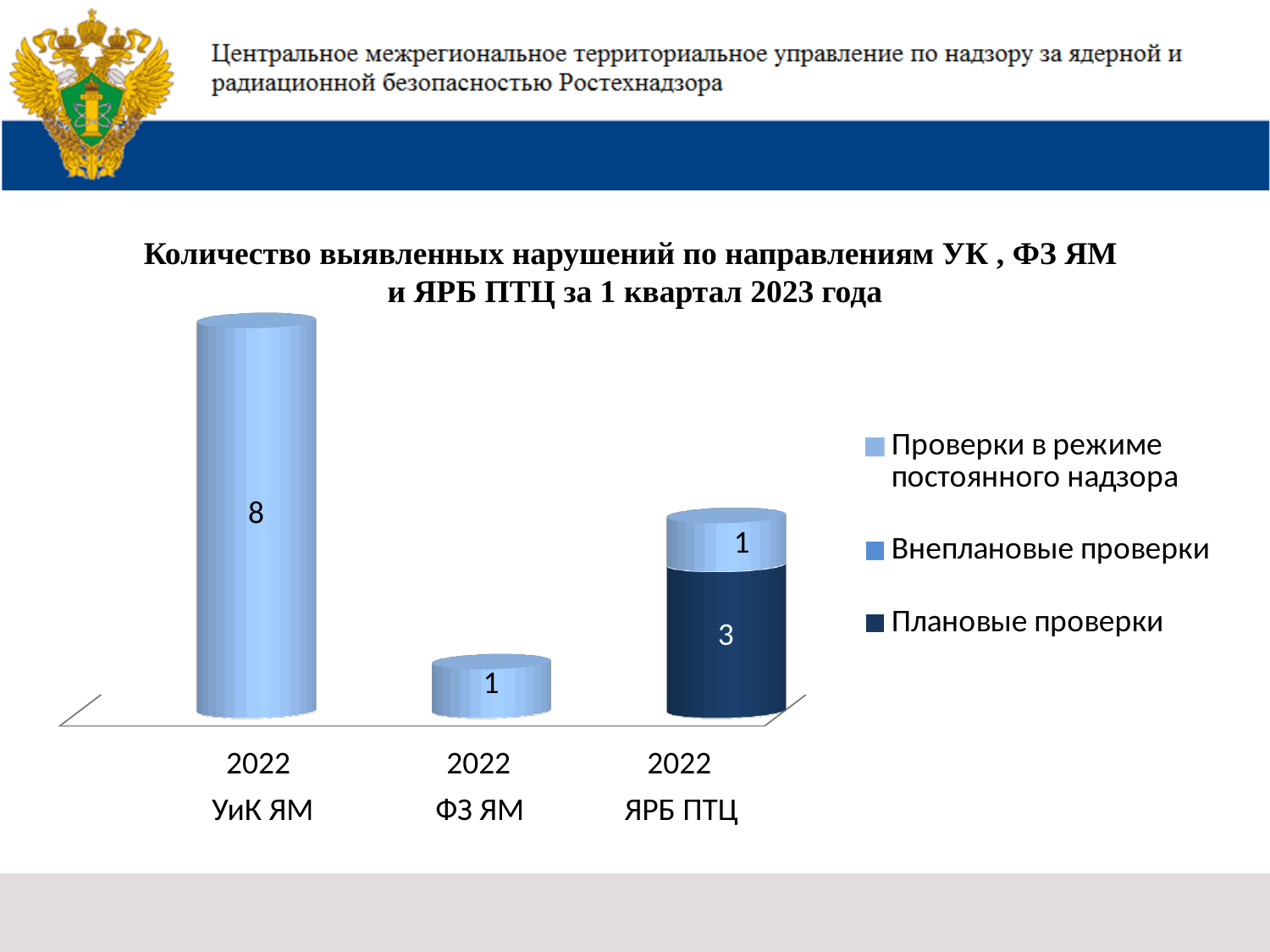
Which category has the highest total number of violations? УиК ЯМ What is the total of the stacked bar for ЯРБ ПТЦ? 4 What is the value for Плановые проверки for ЯРБ ПТЦ? 3 How many series does the legend list? 3 Which series is shown in the darkest blue colour? Плановые проверки What is the value for Проверки в режиме постоянного надзора for ФЗ ЯМ? 1 What is the difference between the value for УиК ЯМ and the Плановые проверки value for ЯРБ ПТЦ? 5 What is the value for Проверки в режиме постоянного надзора for УиК ЯМ? 8 What type of chart is shown on the slide? bar chart How many categories are shown on the x axis? 3 What is the value for Проверки в режиме постоянного надзора for ЯРБ ПТЦ? 1 Which category has the lowest total number of violations? ФЗ ЯМ